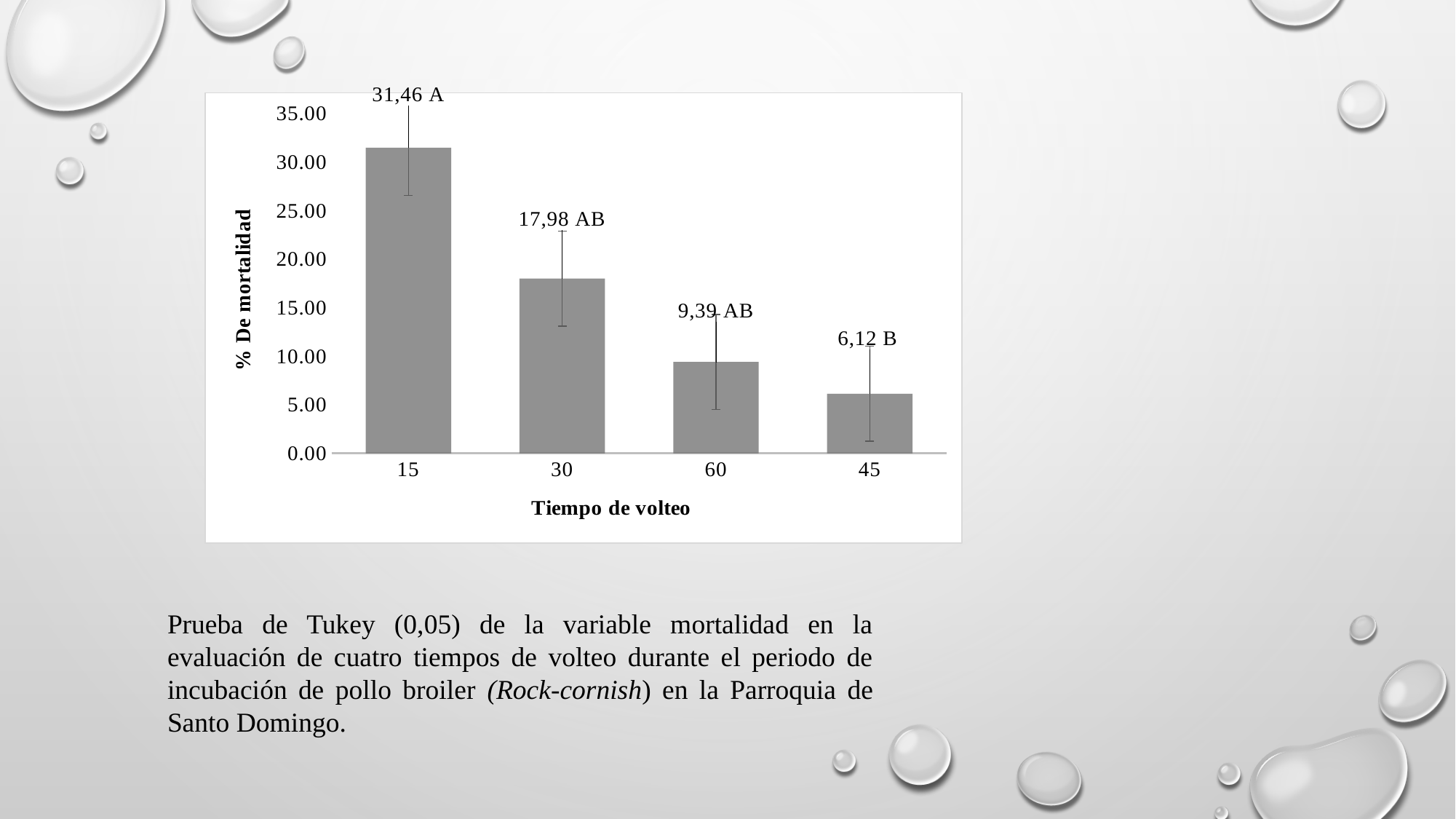
What is the difference between the mortality values for tiempo de volteo 60 and 45? 3,27 Which tiempo de volteo has the highest % de mortalidad? 15 What is the mortality value shown for tiempo de volteo 15? 31,46 Which Tukey letter group is printed next to the bar for tiempo de volteo 45? B Which has a larger % de mortalidad, tiempo de volteo 30 or 60? 30 What is the mortality value shown for tiempo de volteo 45? 6,12 What is the difference between the mortality values for tiempo de volteo 15 and 30? 13,48 Which tiempo de volteo has the lowest % de mortalidad? 45 What kind of chart is shown on the slide? Bar chart What is the mortality value shown for tiempo de volteo 60? 9,39 How many tiempo de volteo categories are plotted in the chart? 4 What is the mortality value shown for tiempo de volteo 30? 17,98